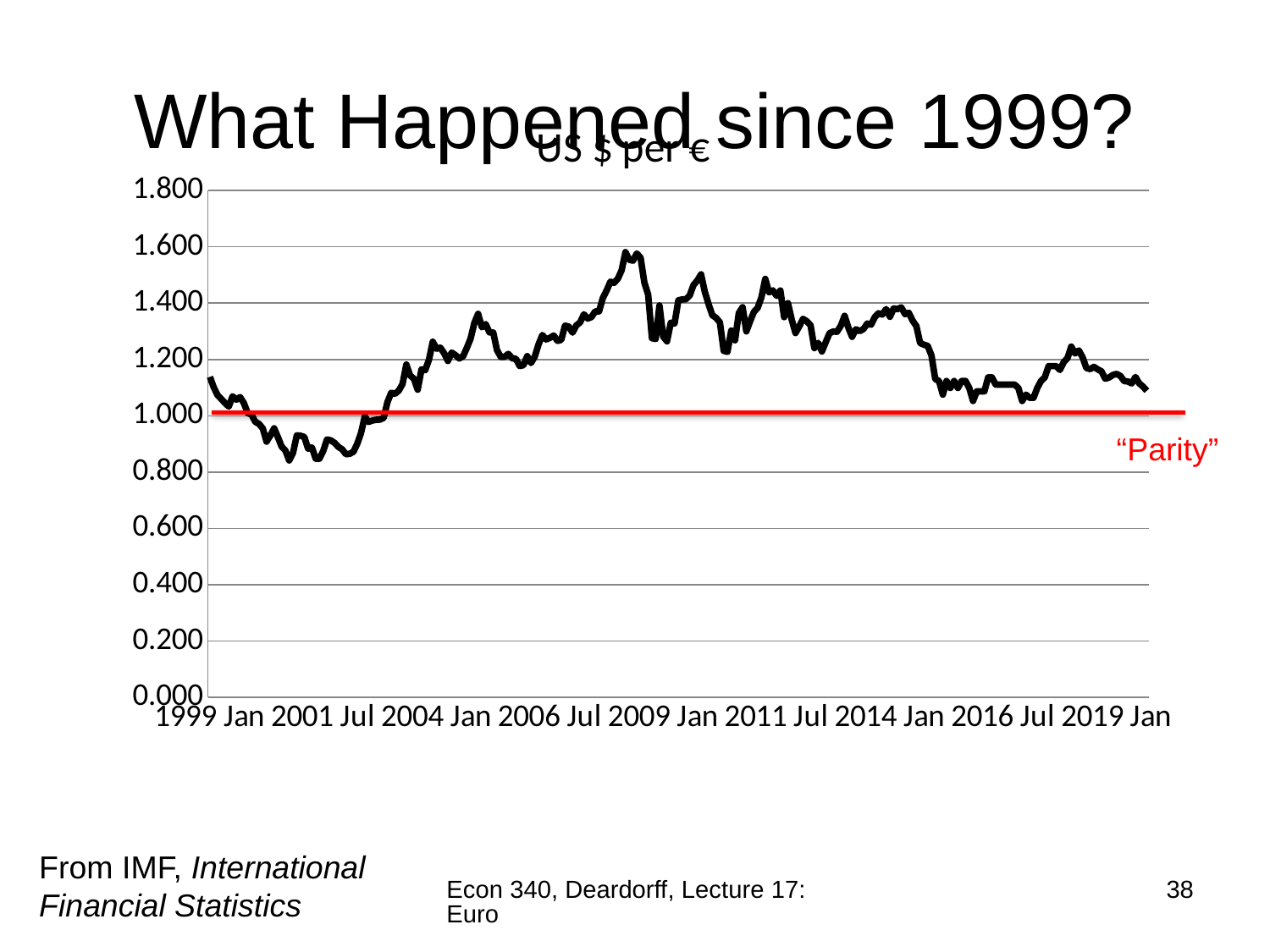
Is the value for 2019 Jan greater or less than 1.000? greater Is the highest value reached by the line greater or less than 1.400? greater Is the value for 2016 Jul greater or less than 1.200? less What is the title of the chart? US $ per € What label is given to the red horizontal line on the chart? "Parity" Which is larger, the value at 2014 Jan or the value at 2016 Jul? 2014 Jan What kind of chart is shown on the slide? line chart How many date labels are shown on the x axis? 9 Does the line rise or fall between 1999 Jan and 2001 Jul? fall